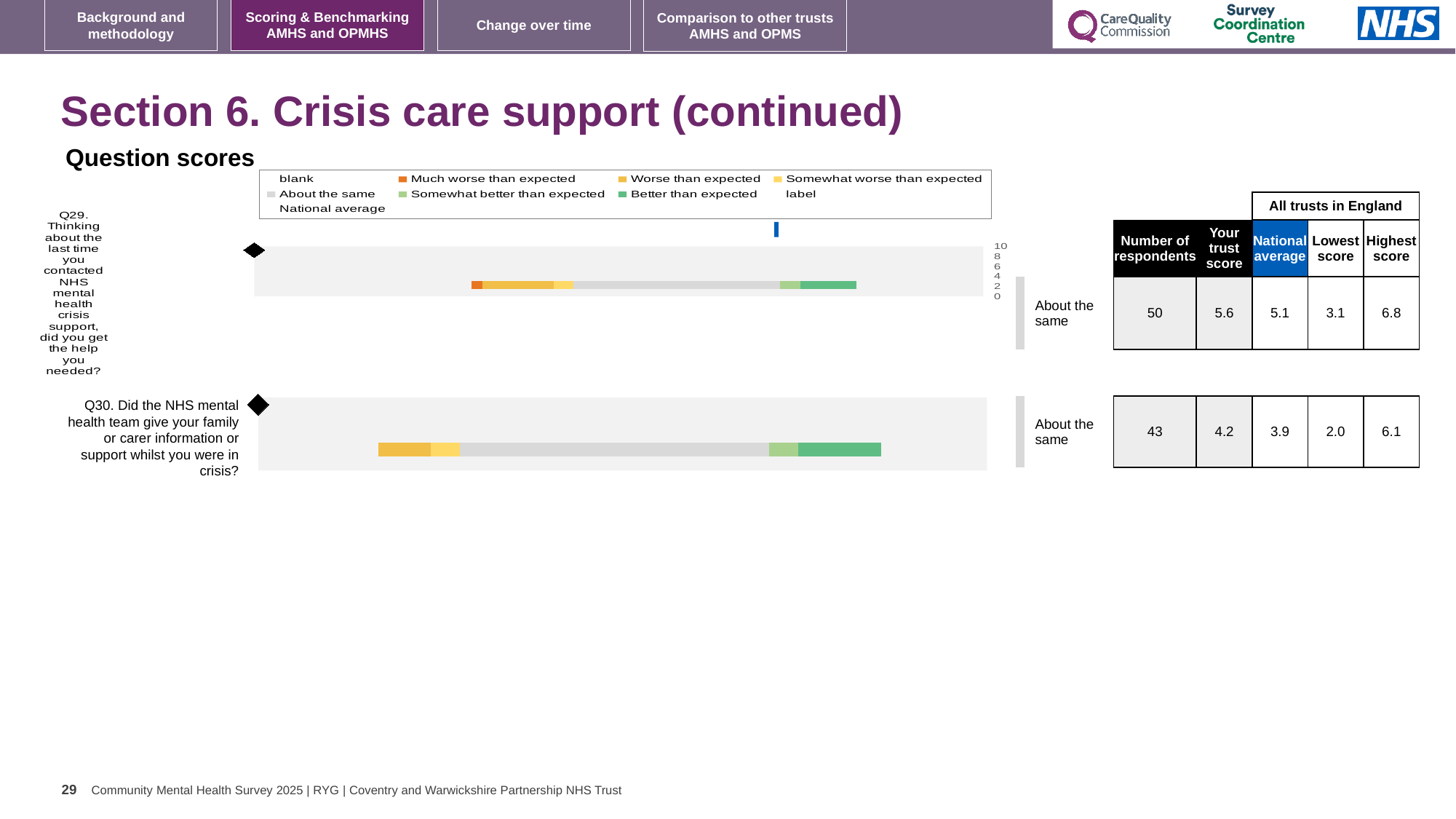
How many entries does the legend above the charts list? 9 How many questions (categories) are plotted on the slide? 2 What colour represents 'Better than expected' in the legend? green What is the national average shown for Q30? 3.9 What benchmark category label is shown next to the Q30 bar? About the same How many respondents are shown for Q29? 50 What is the lowest score across all trusts in England shown for Q29? 3.1 What kind of chart is used to show the question scores for Q29 and Q30? bar chart Which is larger for Q29, the trust score or the national average? the trust score What is the highest score across all trusts in England shown for Q30? 6.1 What is the difference between the trust score and the national average for Q30? 0.3 What is the 'Your trust score' value shown for Q29? 5.6